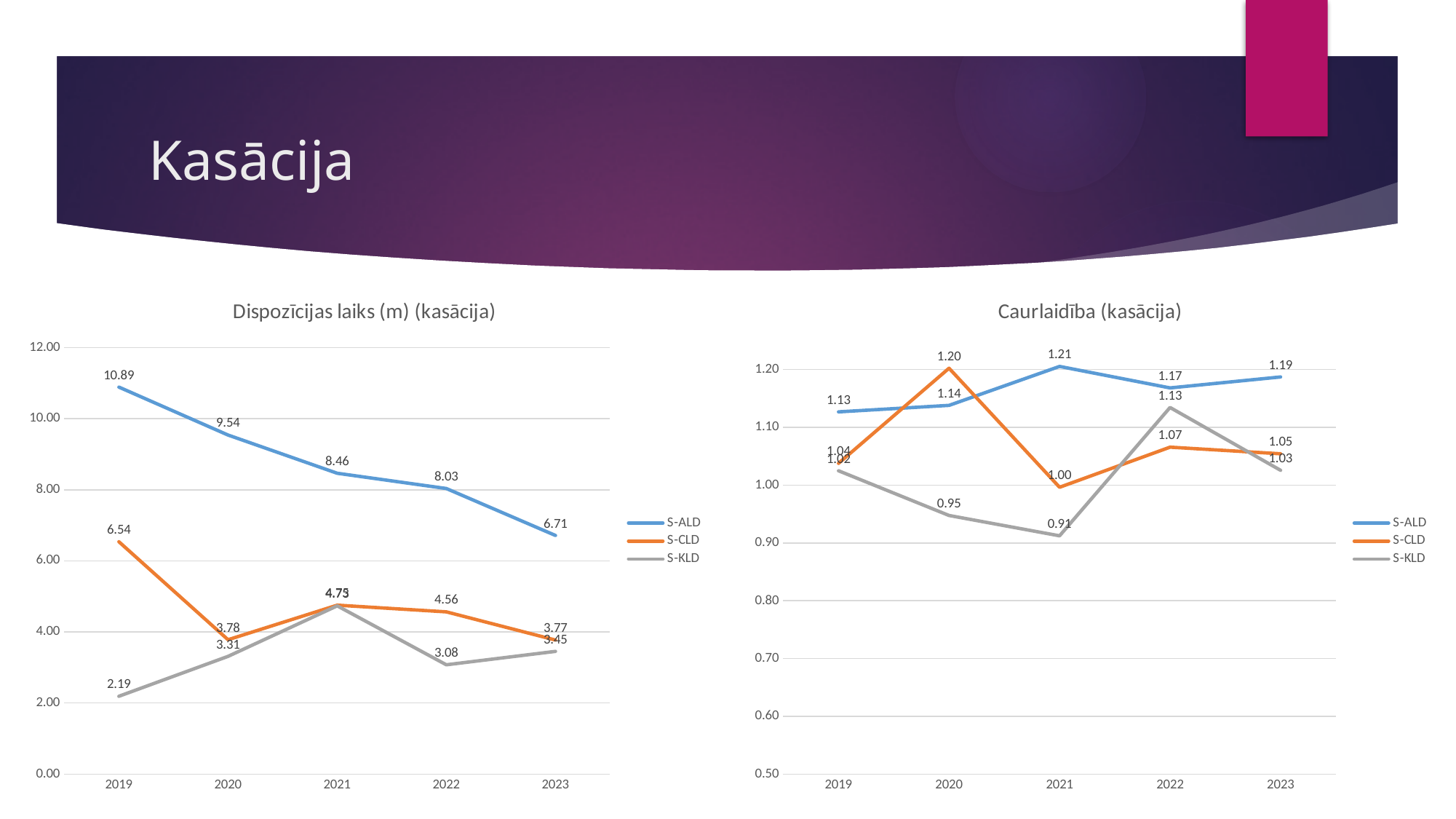
In the chart titled "Caurlaidība (kasācija)", what is the value for S-KLD in 2021? 0.91 In the chart titled "Dispozīcijas laiks (m) (kasācija)", in which year is the S-ALD value lowest? 2023 In the chart titled "Dispozīcijas laiks (m) (kasācija)", which is larger in 2020: S-CLD or S-KLD? S-CLD What kind of chart is the chart titled "Dispozīcijas laiks (m) (kasācija)"? line chart In the chart titled "Dispozīcijas laiks (m) (kasācija)", what is the value for S-ALD in 2019? 10.89 In the chart titled "Dispozīcijas laiks (m) (kasācija)", what is the value for S-KLD in 2022? 3.08 In the chart titled "Dispozīcijas laiks (m) (kasācija)", does the S-ALD series rise or fall from 2019 to 2023? fall How many series does the legend of the chart titled "Caurlaidība (kasācija)" list? 3 In the chart titled "Caurlaidība (kasācija)", what is the value for S-CLD in 2020? 1.20 In the chart titled "Caurlaidība (kasācija)", in which year is the S-ALD value highest? 2021 In the chart titled "Dispozīcijas laiks (m) (kasācija)", what is the difference between the S-ALD values for 2019 and 2023? 4.18 In the chart titled "Caurlaidība (kasācija)", what is the difference between the S-KLD values for 2022 and 2021? 0.22